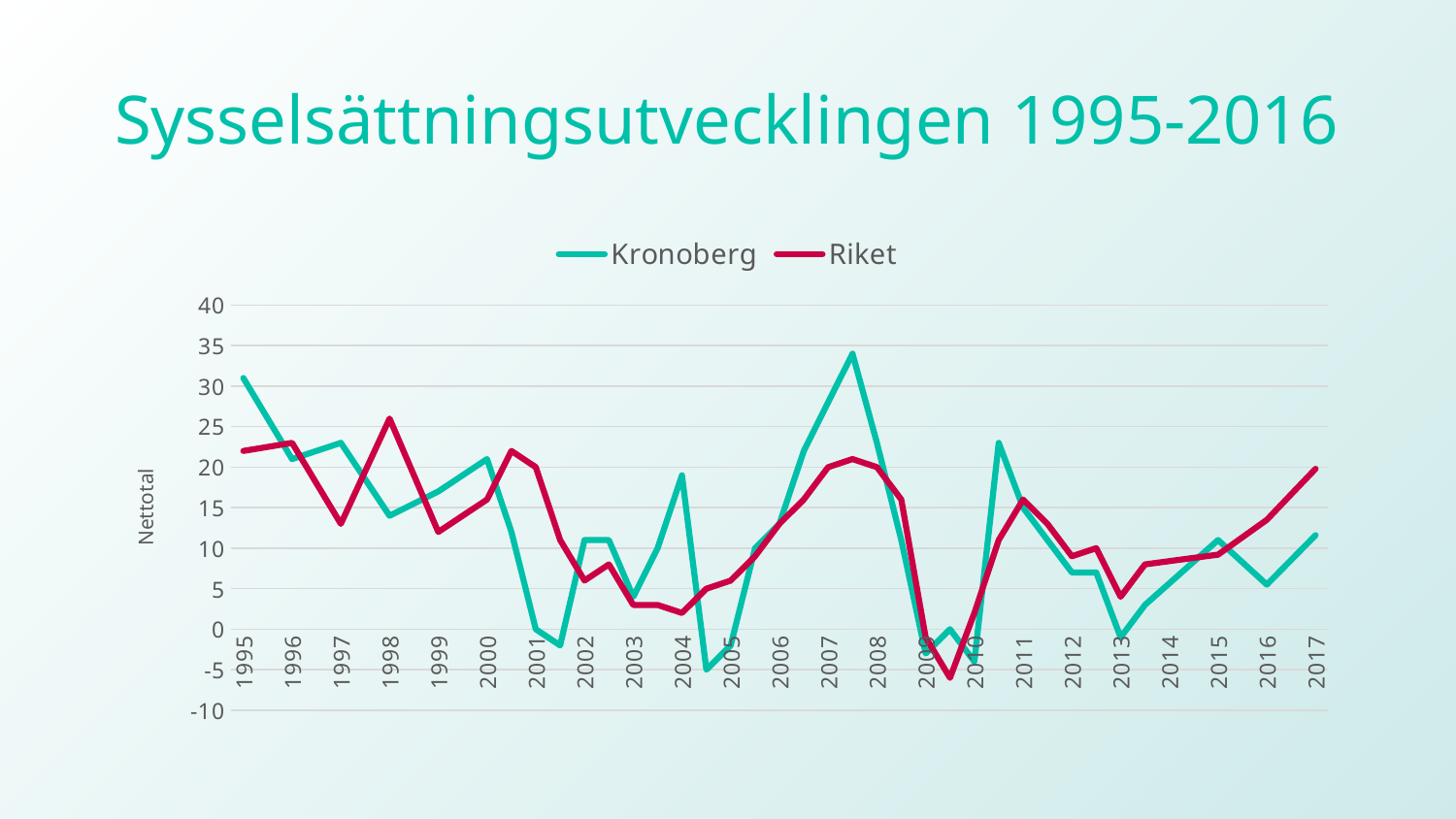
Which series reaches the highest value anywhere on the chart? Kronoberg Is the value for Riket at 1998 greater or less than 20? greater Is the value for Riket at 2017 greater or less than 15? greater What is the title of the chart? Sysselsättningsutvecklingen 1995-2016 At 1998, which series has the larger value, Kronoberg or Riket? Riket Does the Riket line rise or fall from 2013 to 2017? Rise Is the value for Kronoberg at 1995 greater or less than 25? greater What is the label on the vertical axis? Nettotal How many series does the legend list? 2 At 1995, which series has the larger value, Kronoberg or Riket? Kronoberg What kind of chart is shown on the slide? Line chart